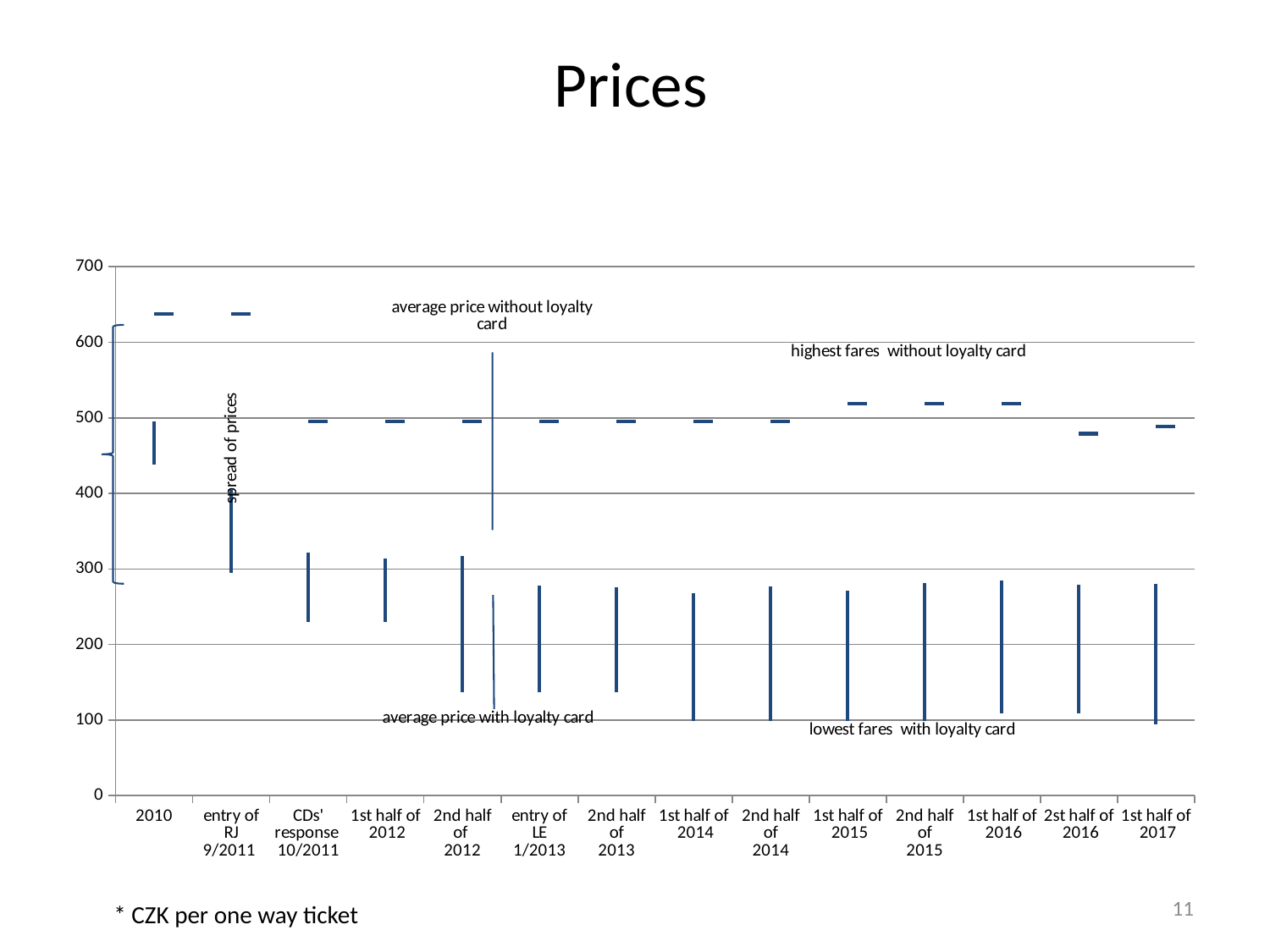
According to the footnote, in what unit are the prices on the chart expressed? CZK per one way ticket Which is larger: the lowest fare in 2010 or the lowest fare in 2nd half of 2012? 2010 Is the lowest price in the 2010 spread greater or less than 400? greater Is the lowest fare with loyalty card for 2nd half of 2013 greater or less than 100? greater Is the highest fare without loyalty card for 1st half of 2015 greater or less than 500? greater Does the average price without loyalty card rise or fall from 2010 to 1st half of 2017? fall Which is larger: the average price without loyalty card in 2010 or in 1st half of 2017? 2010 What is the title of the chart on the slide? Prices How many time-period categories are shown along the x axis of the chart? 14